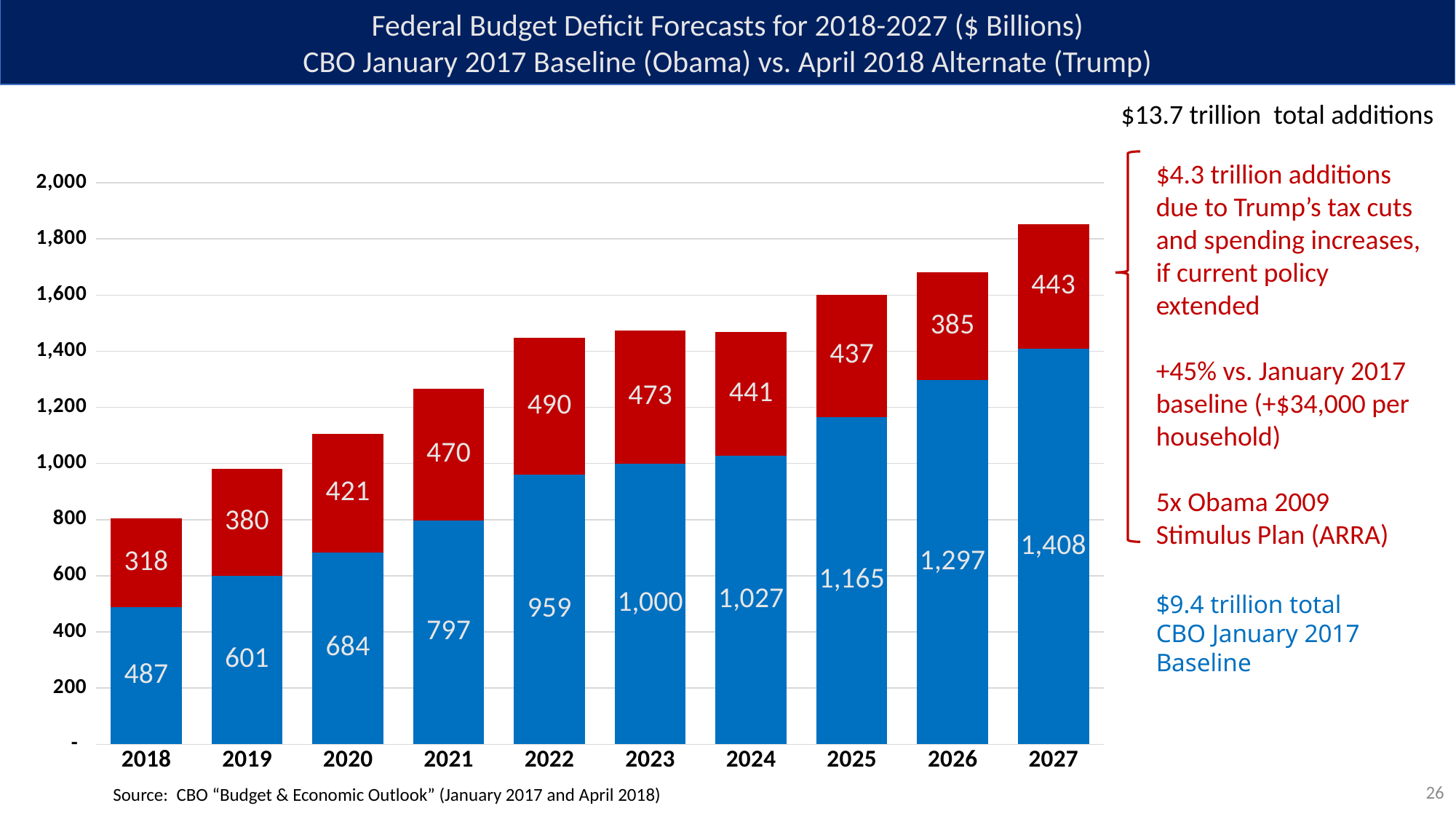
What is the value of the red (additions) segment for 2022? 490 What is the difference between the blue baseline values for 2027 and 2018? 921 What is the total height of the stacked bar for 2018? 805 What is the value of the blue baseline segment for 2027? 1,408 Which year has the larger red additions segment, 2023 or 2024? 2023 How many years are shown on the x axis? 10 In which year is the red additions segment the smallest? 2018 What is the value of the blue (CBO January 2017 Baseline) segment for 2018? 487 What is the total height of the stacked bar for 2027? 1,851 In which year is the red additions segment the largest? 2022 Do the blue baseline values rise or fall from 2018 to 2027? Rise What kind of chart is shown on the slide? Stacked bar chart